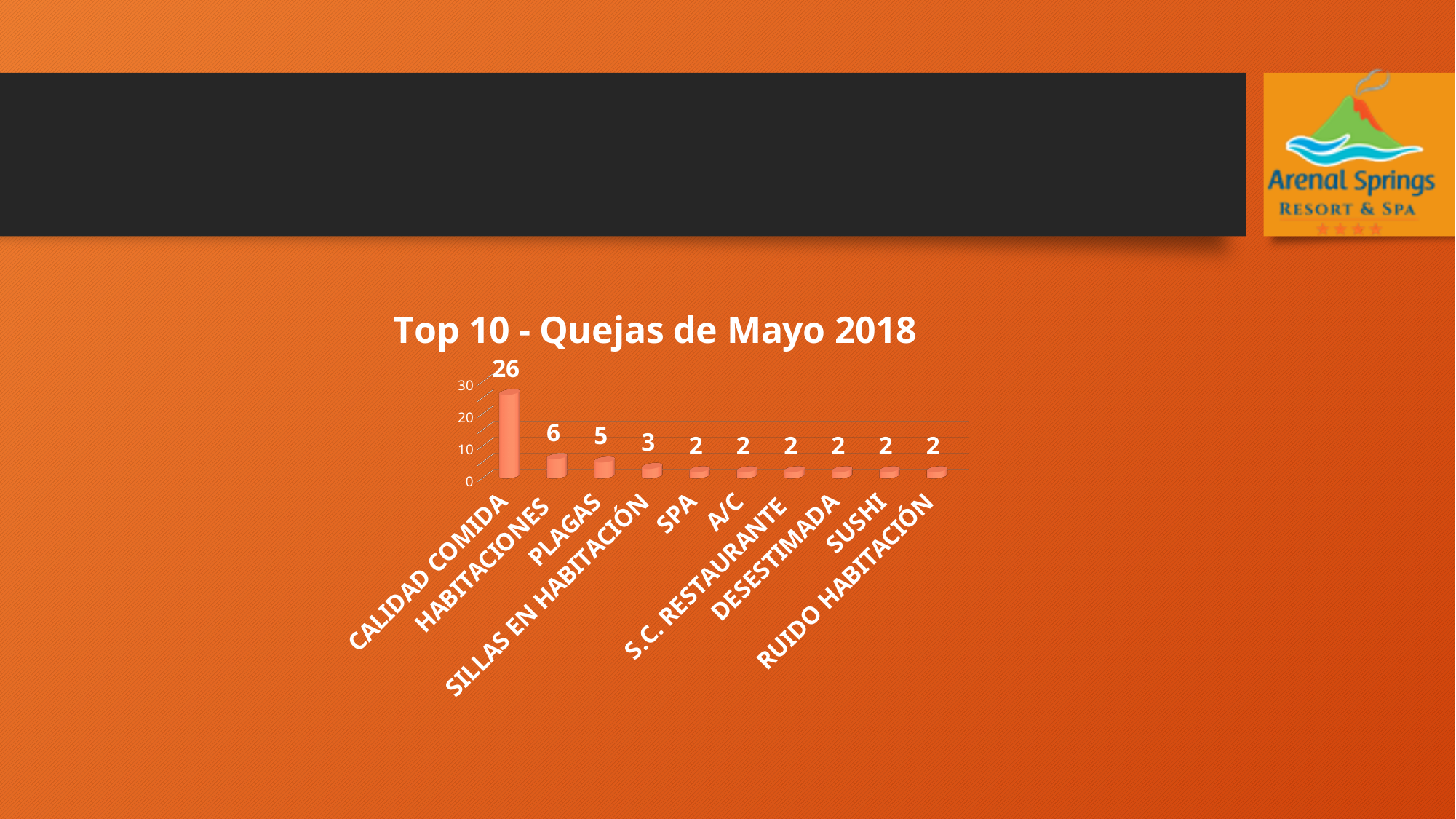
Which is larger, the value for PLAGAS or the value for SILLAS EN HABITACIÓN? PLAGAS What is the value for SILLAS EN HABITACIÓN? 3 Is the value for CALIDAD COMIDA greater or less than 20? greater What is the value for CALIDAD COMIDA? 26 What is the value for HABITACIONES? 6 How many categories are shown on the chart? 10 What is the value for PLAGAS? 5 Which category has the highest value? CALIDAD COMIDA What is the title of the chart? Top 10 - Quejas de Mayo 2018 What is the difference between the values for CALIDAD COMIDA and HABITACIONES? 20 What is the value for SPA? 2 What kind of chart is shown on the slide? Bar chart